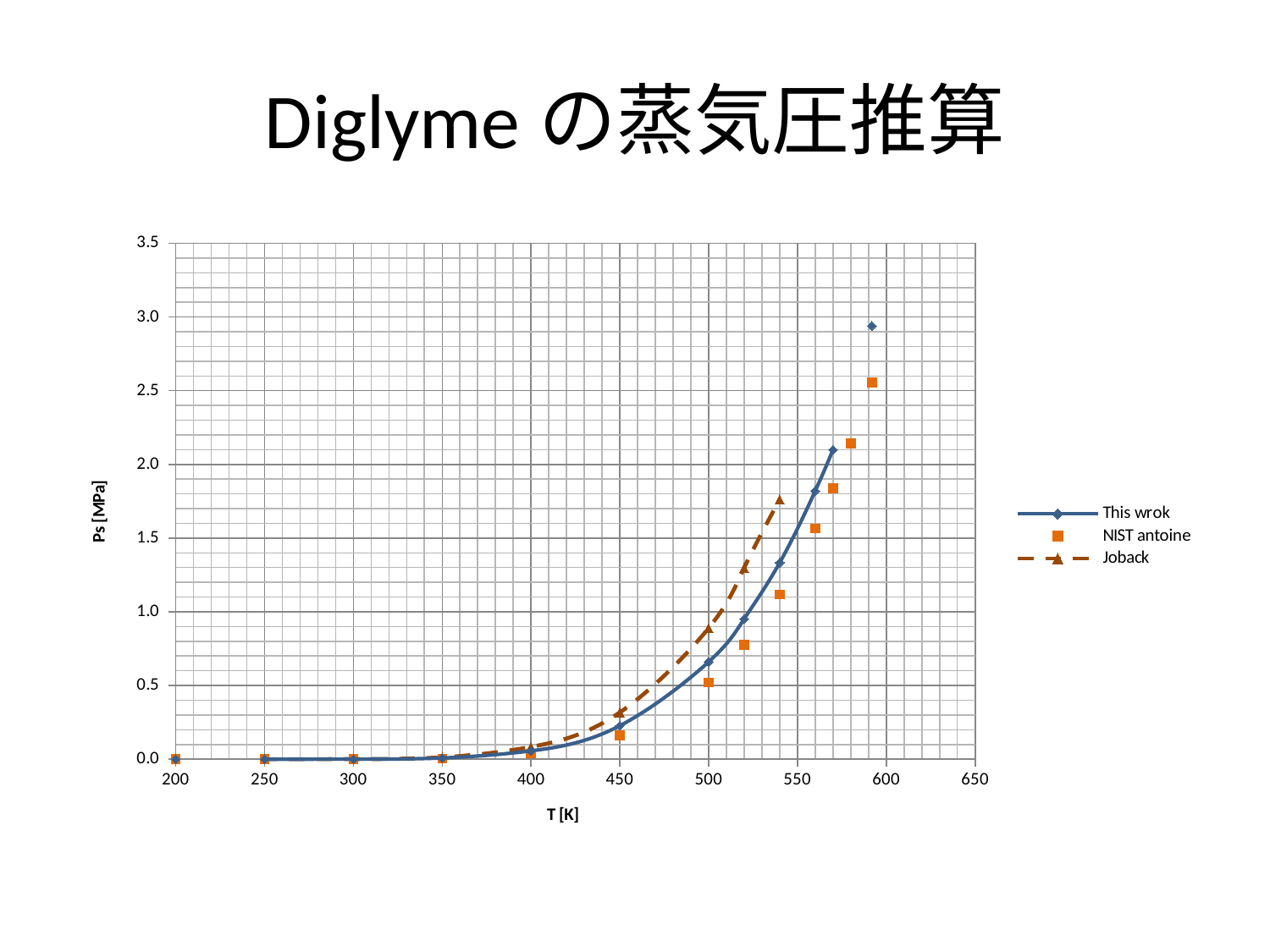
What is the label of the vertical axis? Ps [MPa] Is the value of the 'This wrok' series at 570 K greater or less than 2.0? greater Is the value of the 'This wrok' series at 500 K greater or less than 1.0? less What kind of chart is shown on the slide? line chart How many series does the legend list? 3 Is the value of the 'NIST antoine' series at 500 K greater or less than 1.0? less At 540 K, which series has the larger value, 'Joback' or 'This wrok'? Joback Do the values of the 'This wrok' series rise or fall as T increases? rise What is the label of the horizontal axis? T [K] At about 590 K, which series has the larger value, 'This wrok' or 'NIST antoine'? This wrok